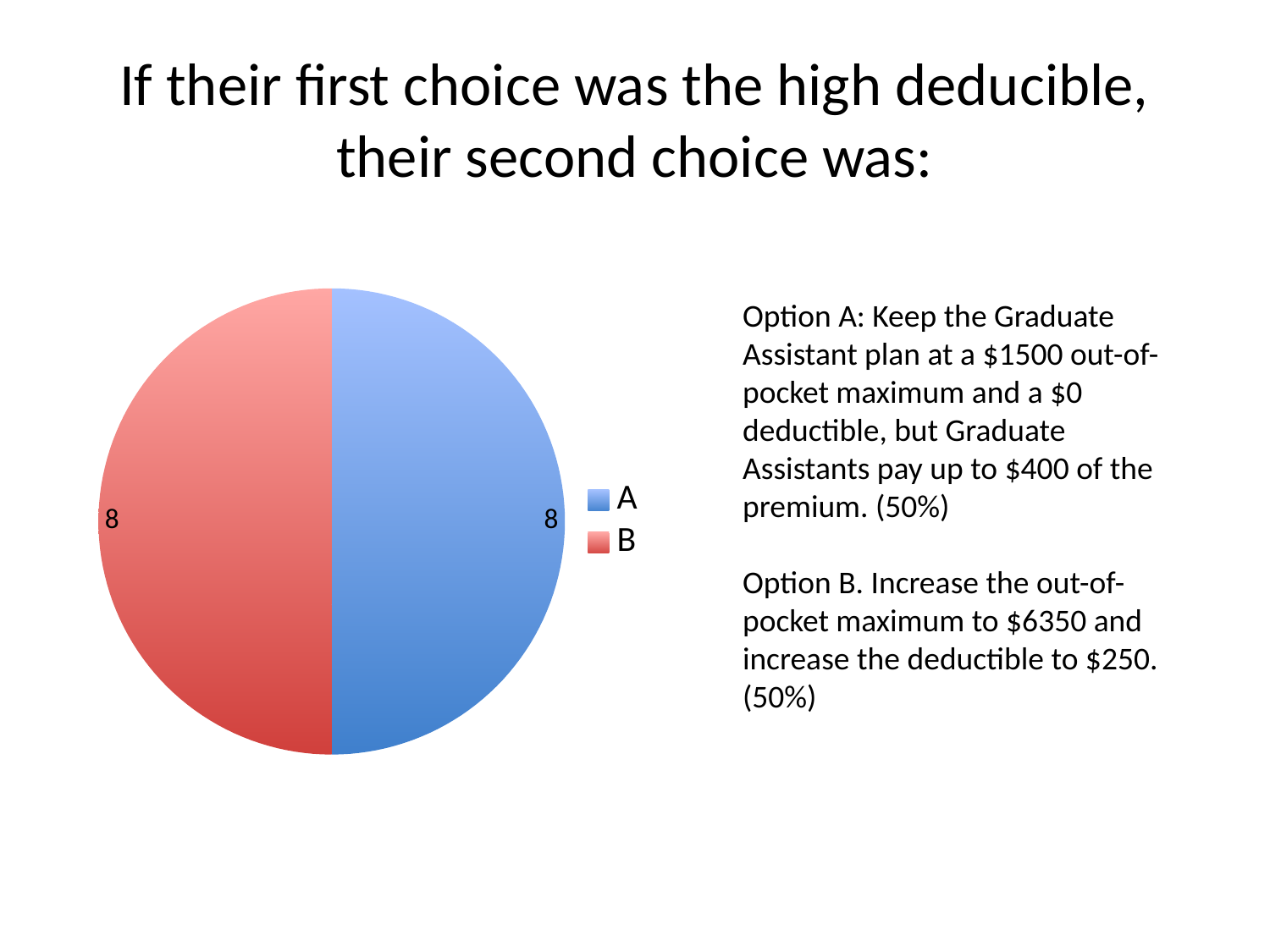
What kind of chart is shown on the slide? pie chart How many entries does the legend list? 2 What is the total of all slices in the pie chart? 16 How many slices does the pie chart have? 2 What is the difference between the values for A and B? 0 What share of the pie does slice A represent? 50% Which colour is used for slice B in the pie chart? red What share of the pie does slice B represent? 50% What is the value for slice A? 8 What is the value for slice B? 8 Which colour is used for slice A in the pie chart? blue